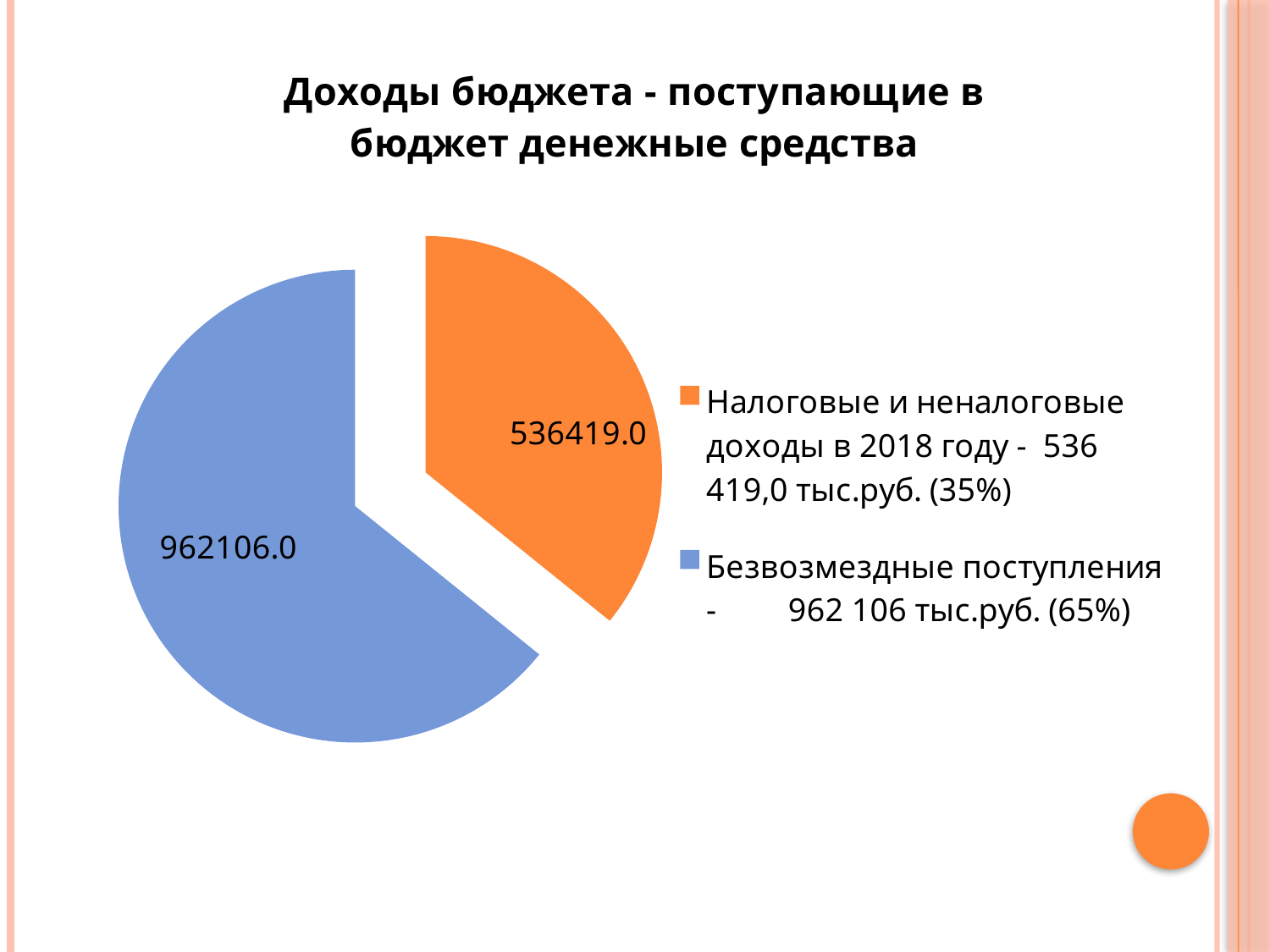
What is the value of the slice for Налоговые и неналоговые доходы в 2018 году? 536419.0 Which category has the smallest slice of the pie? Налоговые и неналоговые доходы в 2018 году How many entries does the legend list? 2 What is the value of the slice for Безвозмездные поступления? 962106.0 What share of the pie does Налоговые и неналоговые доходы в 2018 году represent, according to the legend? 35% Which category has the largest slice of the pie? Безвозмездные поступления What type of chart is shown on the slide? pie chart Which is larger: the value for Безвозмездные поступления or the value for Налоговые и неналоговые доходы в 2018 году? Безвозмездные поступления What colour is the slice for Безвозмездные поступления? blue What is the difference between the value for Безвозмездные поступления and the value for Налоговые и неналоговые доходы в 2018 году? 425687.0 What share of the pie does Безвозмездные поступления represent, according to the legend? 65% How many slices does the pie chart have? 2